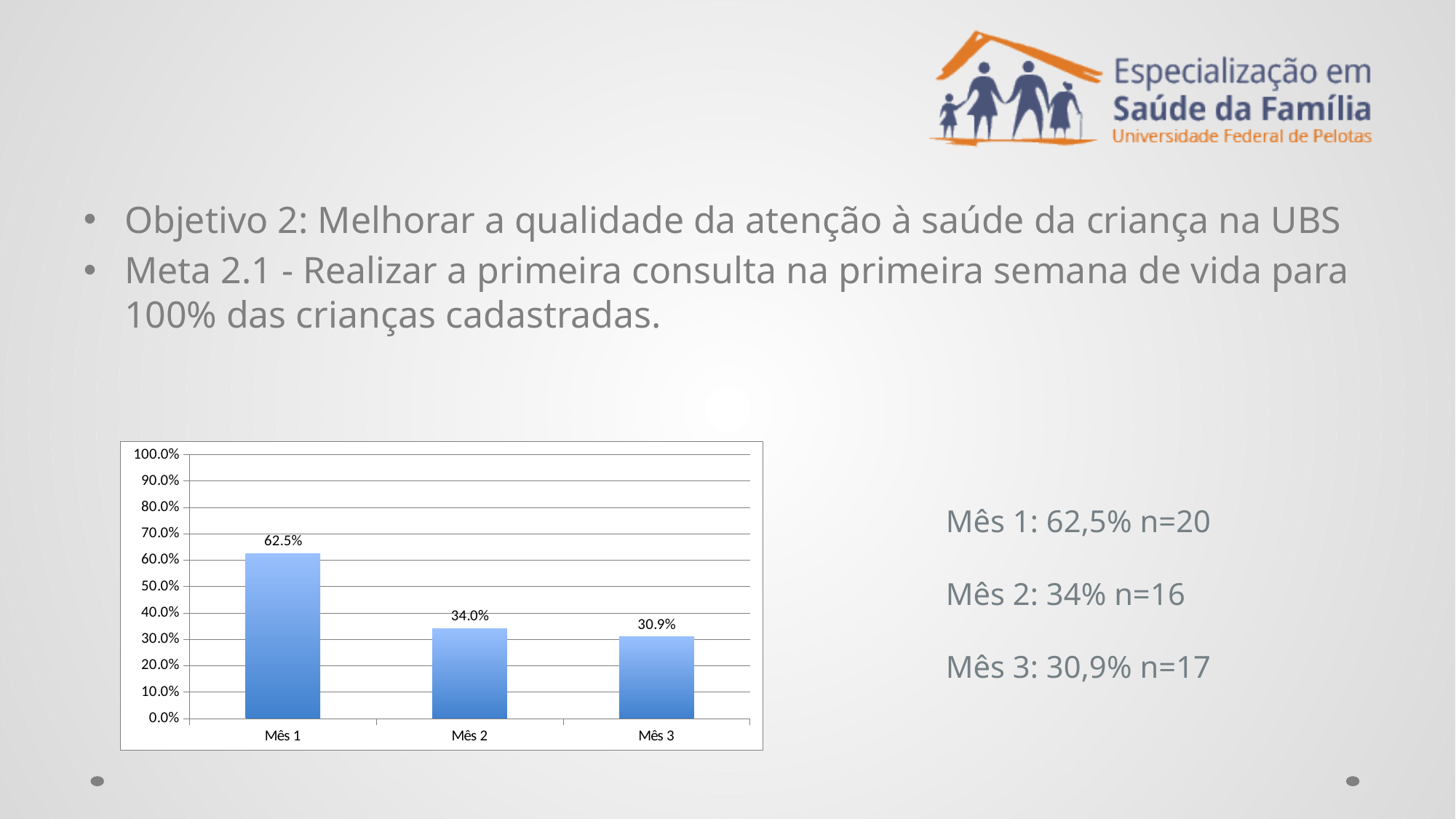
What is the difference between the values for Mês 2 and Mês 3? 3.1% Is the value for Mês 1 greater or less than 50.0%? greater What kind of chart is shown on the slide? bar chart Which month has the lowest value? Mês 3 Do the values rise or fall from Mês 1 to Mês 3? fall Which month has the highest value? Mês 1 What is the value for Mês 2? 34.0% How many categories are shown on the x axis? 3 What is the difference between the values for Mês 1 and Mês 2? 28.5% What is the value for Mês 1? 62.5% What is the value for Mês 3? 30.9% Which is larger, the value for Mês 1 or the value for Mês 3? Mês 1